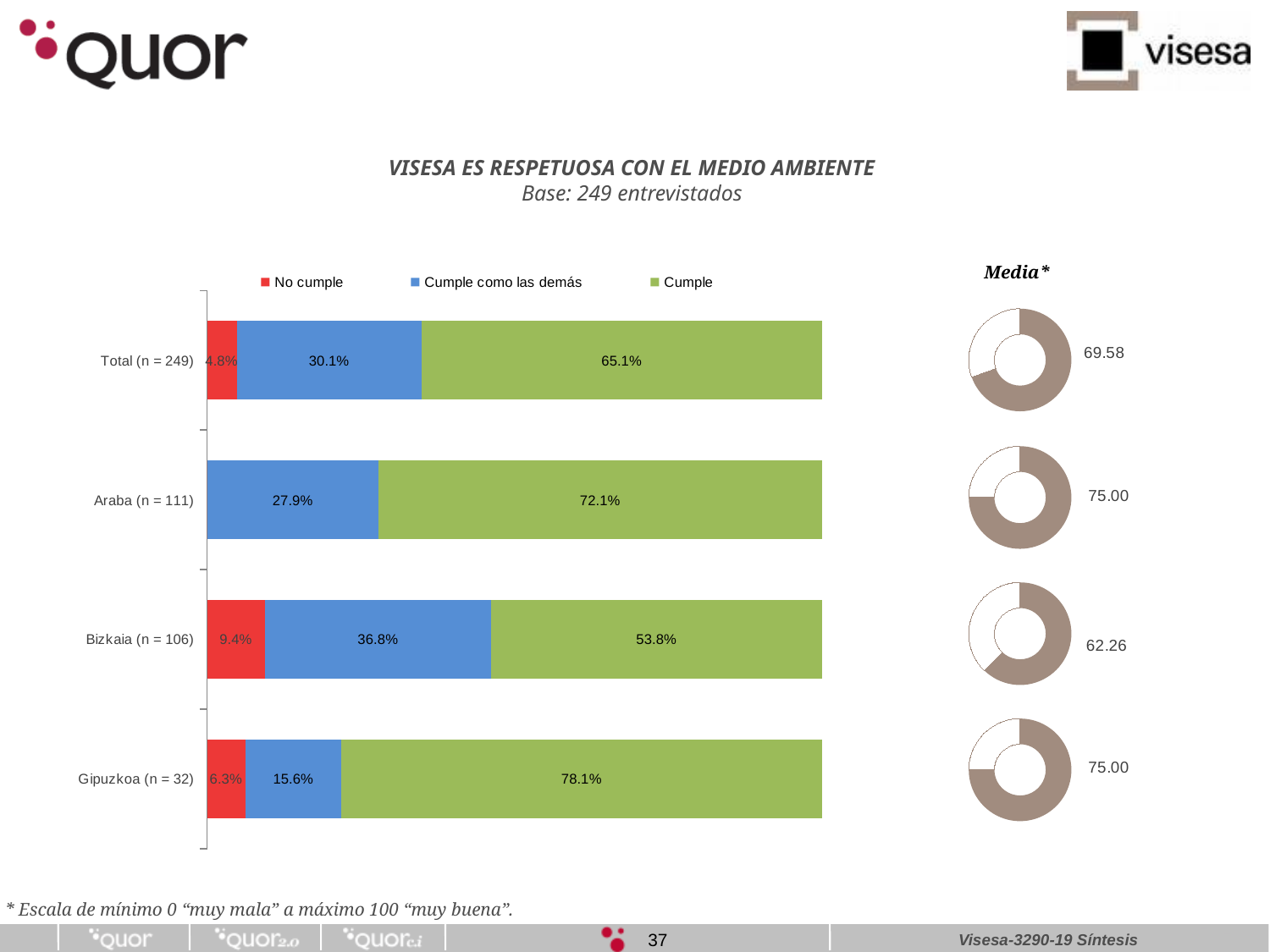
How many categories are shown in the stacked bar chart? 4 In the stacked bar chart, which has a larger "Cumple como las demás" value: Total (n = 249) or Bizkaia (n = 106)? Bizkaia (n = 106) In the stacked bar chart, what percentage of respondents in Bizkaia (n = 106) answered "Cumple"? 53.8% In the Media* donut charts on the right, what is the mean value shown for Bizkaia (n = 106)? 62.26 In the stacked bar chart, what is the "No cumple" value for Gipuzkoa (n = 32)? 6.3% In the Media* donut charts on the right, which category has the lowest mean value? Bizkaia (n = 106) How many series does the legend of the stacked bar chart list? 3 In the stacked bar chart, which category has the lowest "Cumple" percentage? Bizkaia (n = 106) In the stacked bar chart, which category has the highest "Cumple" percentage? Gipuzkoa (n = 32) In the stacked bar chart, what is the "Cumple como las demás" value for Araba (n = 111)? 27.9% In the stacked bar chart, what is the difference between the "Cumple" value for Gipuzkoa (n = 32) and for Bizkaia (n = 106)? 24.3 percentage points What kind of chart is the main chart on the left of the slide? Stacked bar chart